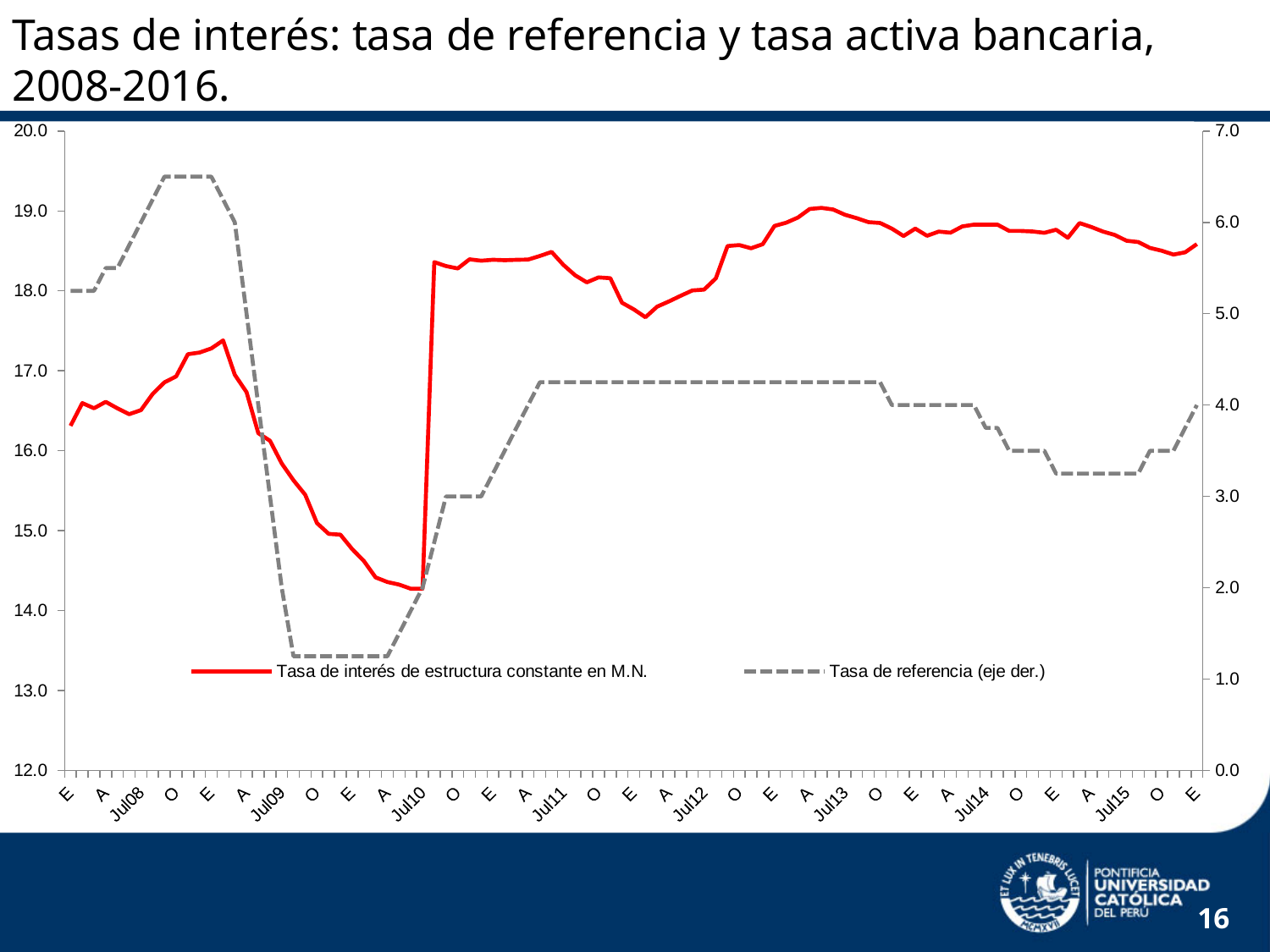
What kind of chart is shown on the slide? line chart Is the value of the red solid line (Tasa de interés de estructura constante en M.N.) at the April 2010 tick (A before Jul10) greater or less than 15.0? less Which series is plotted on the right-hand axis according to the legend? Tasa de referencia (eje der.) What is the highest value shown on the left vertical axis? 20.0 Is the red solid line higher at Jul13 or at Jul09? Jul13 Is the value of the red solid line (Tasa de interés de estructura constante en M.N.) at Jul13 greater or less than 18.0? greater Does the red solid line rise or fall between Jul09 and the April 2010 tick? fall Is the value of the grey dashed line (Tasa de referencia) at the October 2008 tick (O after Jul08) greater or less than 6.0 on the right axis? greater Does the grey dashed line rise or fall between Jul10 and Jul11? rise How many series does the legend list? 2